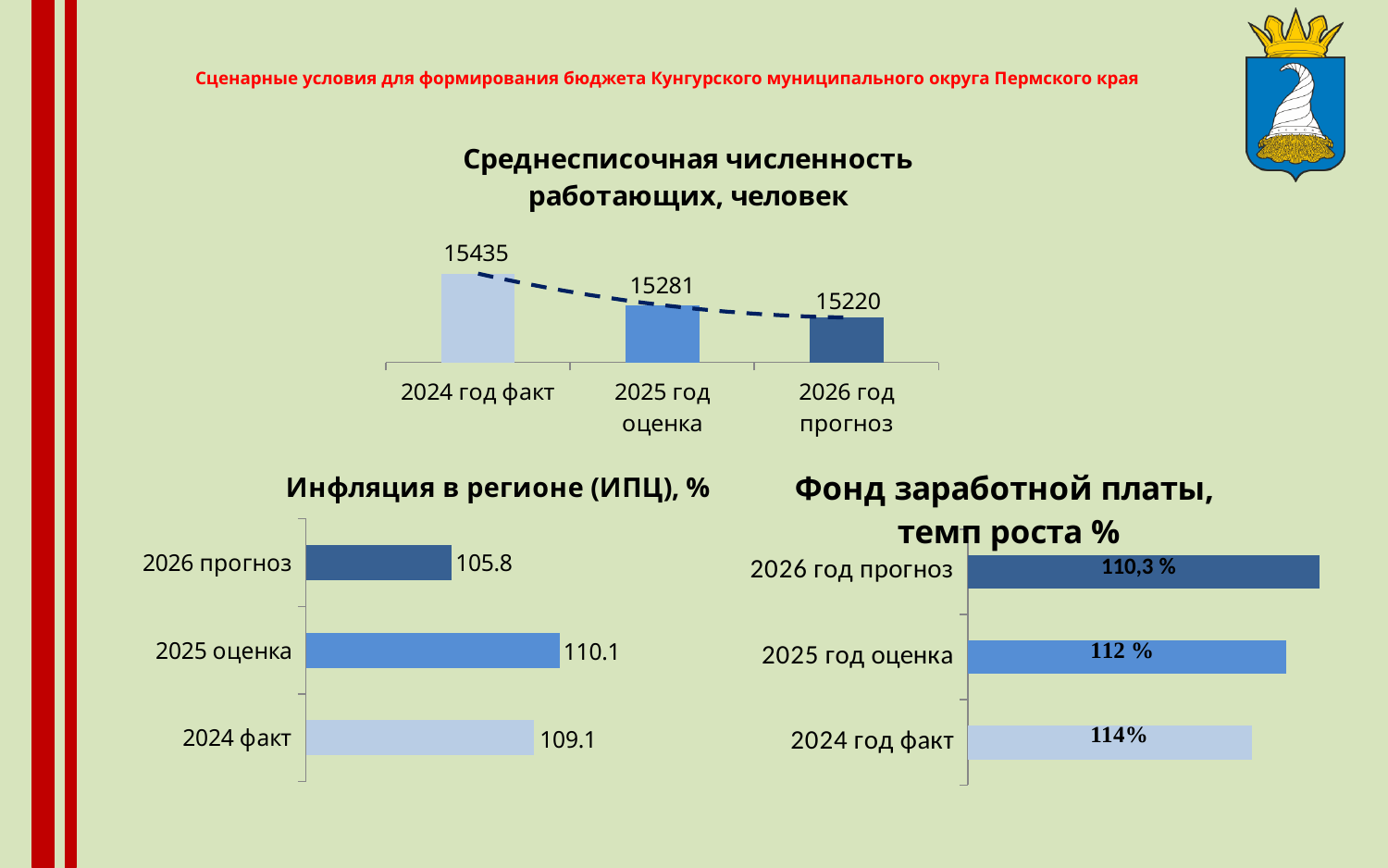
How many bars are in the chart 'Среднесписочная численность работающих, человек'? 3 In the chart 'Инфляция в регионе (ИПЦ), %', which category has the highest value? 2025 оценка In the chart 'Среднесписочная численность работающих, человек', do the values rise or fall from 2024 to 2026? fall How many charts are shown on the slide? 3 In the chart 'Среднесписочная численность работающих, человек', what is the value for '2024 год факт'? 15435 In the chart 'Фонд заработной платы, темп роста %', what is the value for '2026 год прогноз'? 110,3 % In the chart 'Инфляция в регионе (ИПЦ), %', which is larger: the value for 2024 факт or 2026 прогноз? 2024 факт In the chart 'Среднесписочная численность работающих, человек', which category has the lowest value? 2026 год прогноз What type of chart is 'Фонд заработной платы, темп роста %'? bar chart In the chart 'Инфляция в регионе (ИПЦ), %', what is the value for '2025 оценка'? 110.1 In the chart 'Среднесписочная численность работающих, человек', what is the difference between the 2024 год факт and 2026 год прогноз values? 215